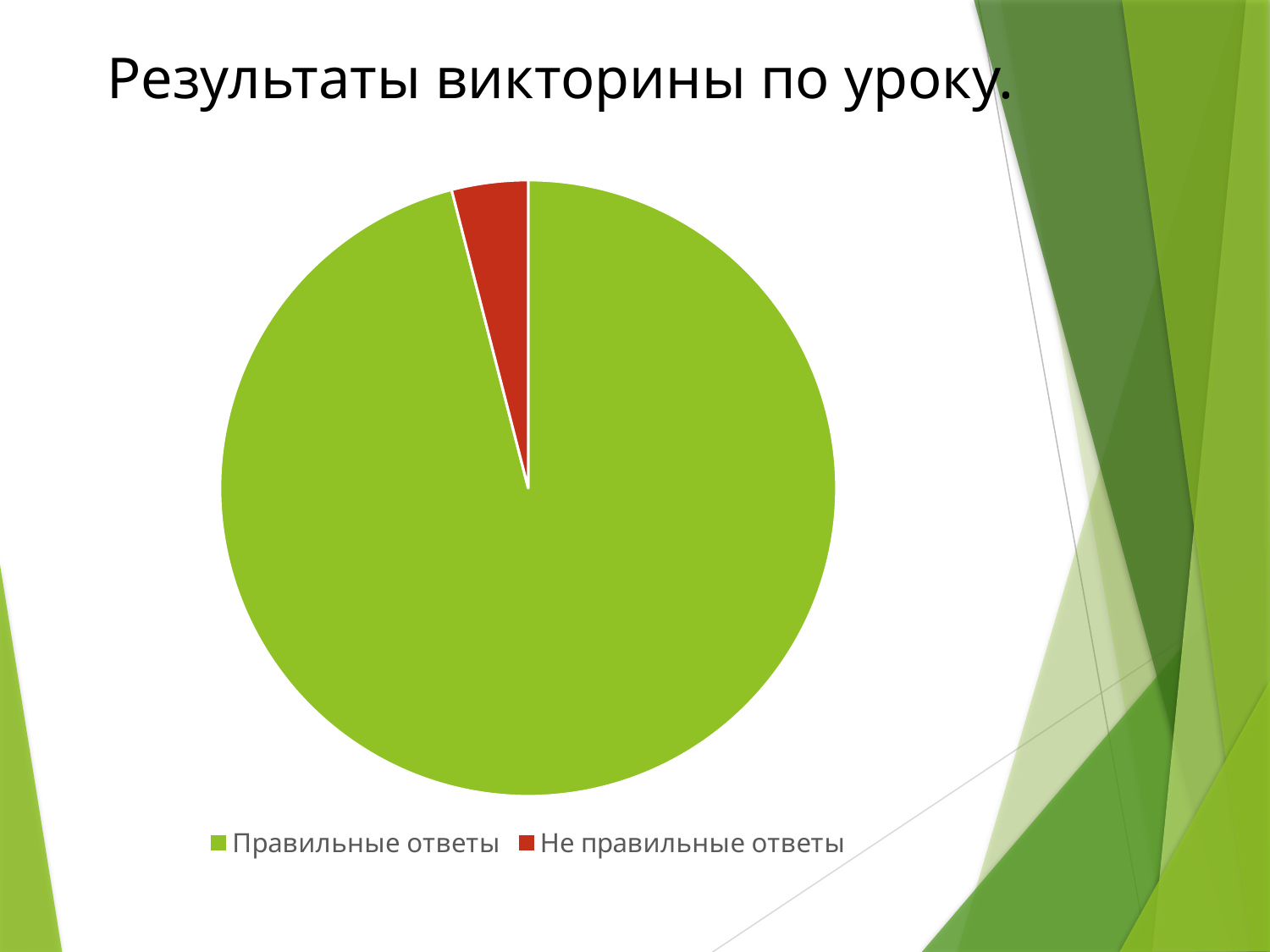
Which slice of the pie chart is the largest? Правильные ответы Which is larger, the slice for Правильные ответы or the slice for Не правильные ответы? Правильные ответы How many entries does the legend list? 2 What colour is the slice for Не правильные ответы? red What kind of chart is shown on the slide? pie chart What is the title of the slide above the chart? Результаты викторины по уроку. Which slice of the pie chart is the smallest? Не правильные ответы How many slices does the pie chart have? 2